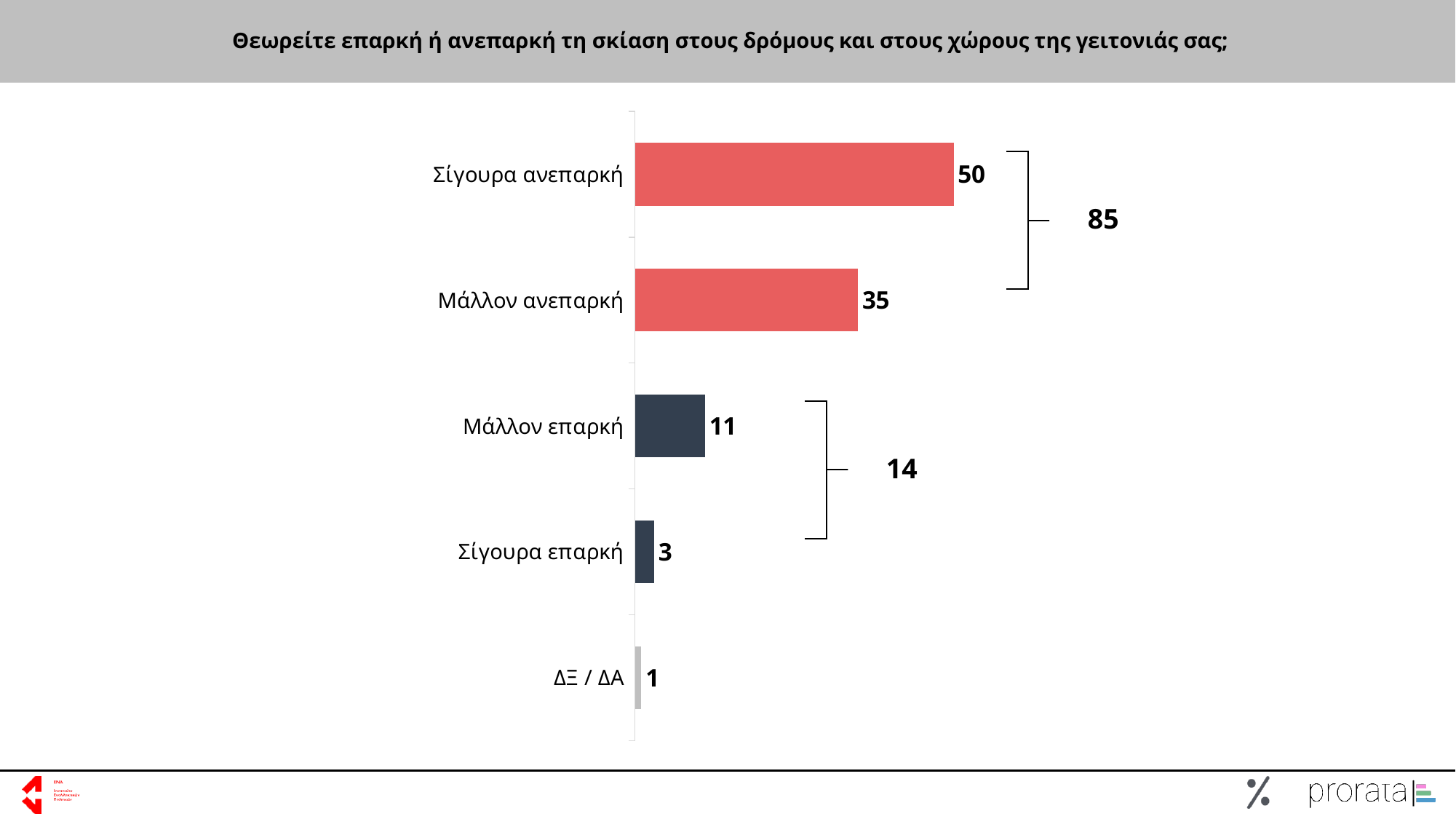
Which category has the highest value? Σίγουρα ανεπαρκή What is the difference between the values for Σίγουρα ανεπαρκή and Μάλλον ανεπαρκή? 15 What is the value for Μάλλον επαρκή? 11 Which category has the lowest value? ΔΞ / ΔΑ What is the value for Σίγουρα επαρκή? 3 What is the value for Σίγουρα ανεπαρκή? 50 What is the value for Μάλλον ανεπαρκή? 35 How many categories are shown in the chart? 5 What combined value is shown by the bracket grouping Σίγουρα ανεπαρκή and Μάλλον ανεπαρκή? 85 What is the value for ΔΞ / ΔΑ? 1 What kind of chart is shown on the slide? Bar chart Which is larger, the value for Μάλλον επαρκή or the value for Σίγουρα επαρκή? Μάλλον επαρκή